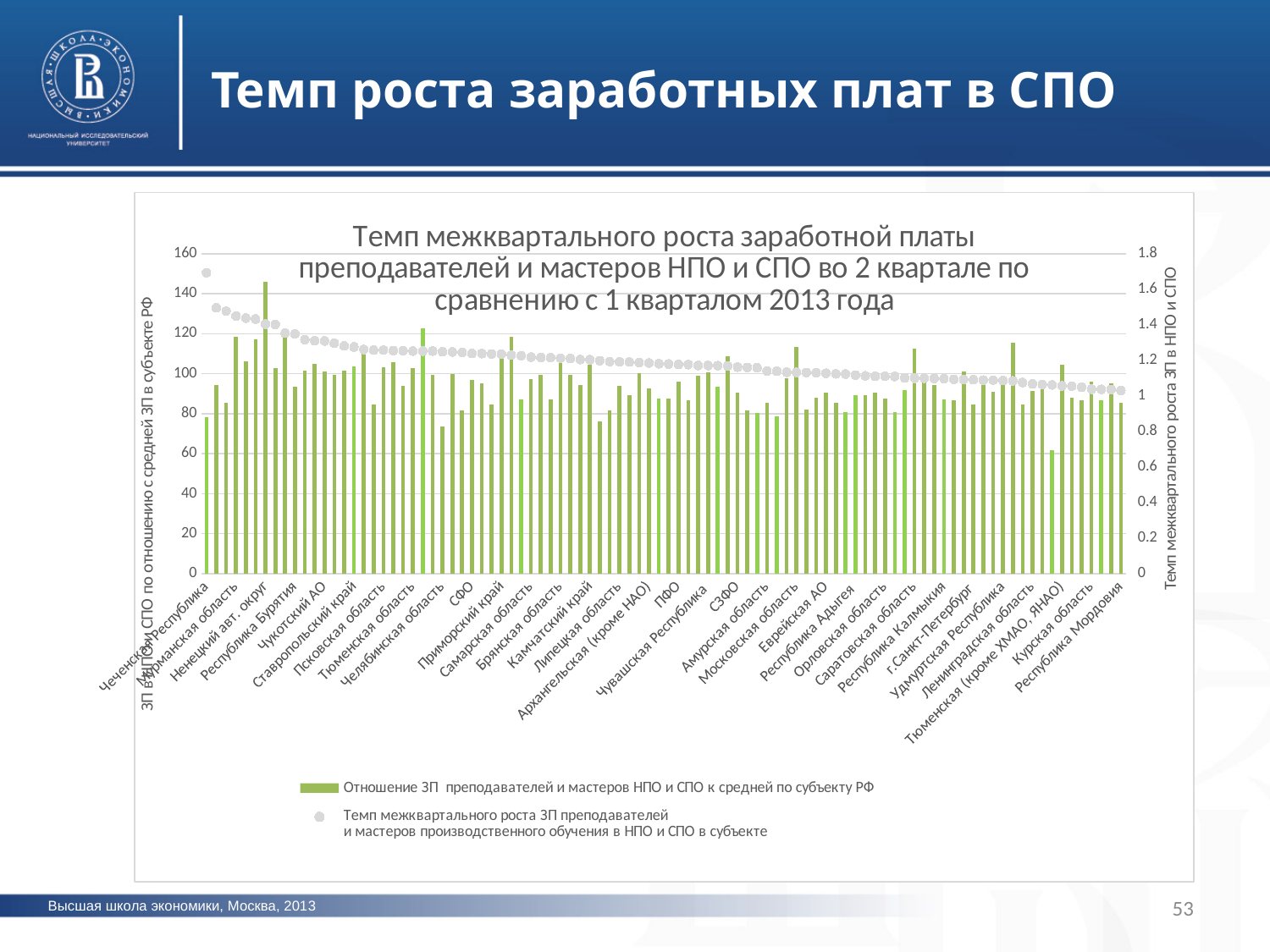
Is the dot value (Темп межквартального роста ЗП) for Республика Мордовия greater or less than 1.4? less What is the title of the chart on the slide? Темп межквартального роста заработной платы преподавателей и мастеров НПО и СПО во 2 квартале по сравнению с 1 кварталом 2013 года Is the bar value (Отношение ЗП к средней по субъекту РФ) for Республика Мордовия greater or less than 100? less Which series is drawn as green bars according to the legend? Отношение ЗП преподавателей и мастеров НПО и СПО к средней по субъекту РФ Do the grey dots (Темп межквартального роста ЗП) rise or fall from left to right along the x axis? fall What kind of chart is shown on the slide? A bar chart combined with a dot (marker) series on a secondary axis What is the maximum value shown on the left vertical axis of the chart? 160 How many series does the chart's legend list? 2 Which is larger for Чеченская Республика: the dot value compared with the dot value for Республика Мордовия? Чеченская Республика Which region has the highest value for the dot series (Темп межквартального роста ЗП)? Чеченская Республика Is the dot value (Темп межквартального роста ЗП) for Чеченская Республика greater or less than 1.4? greater